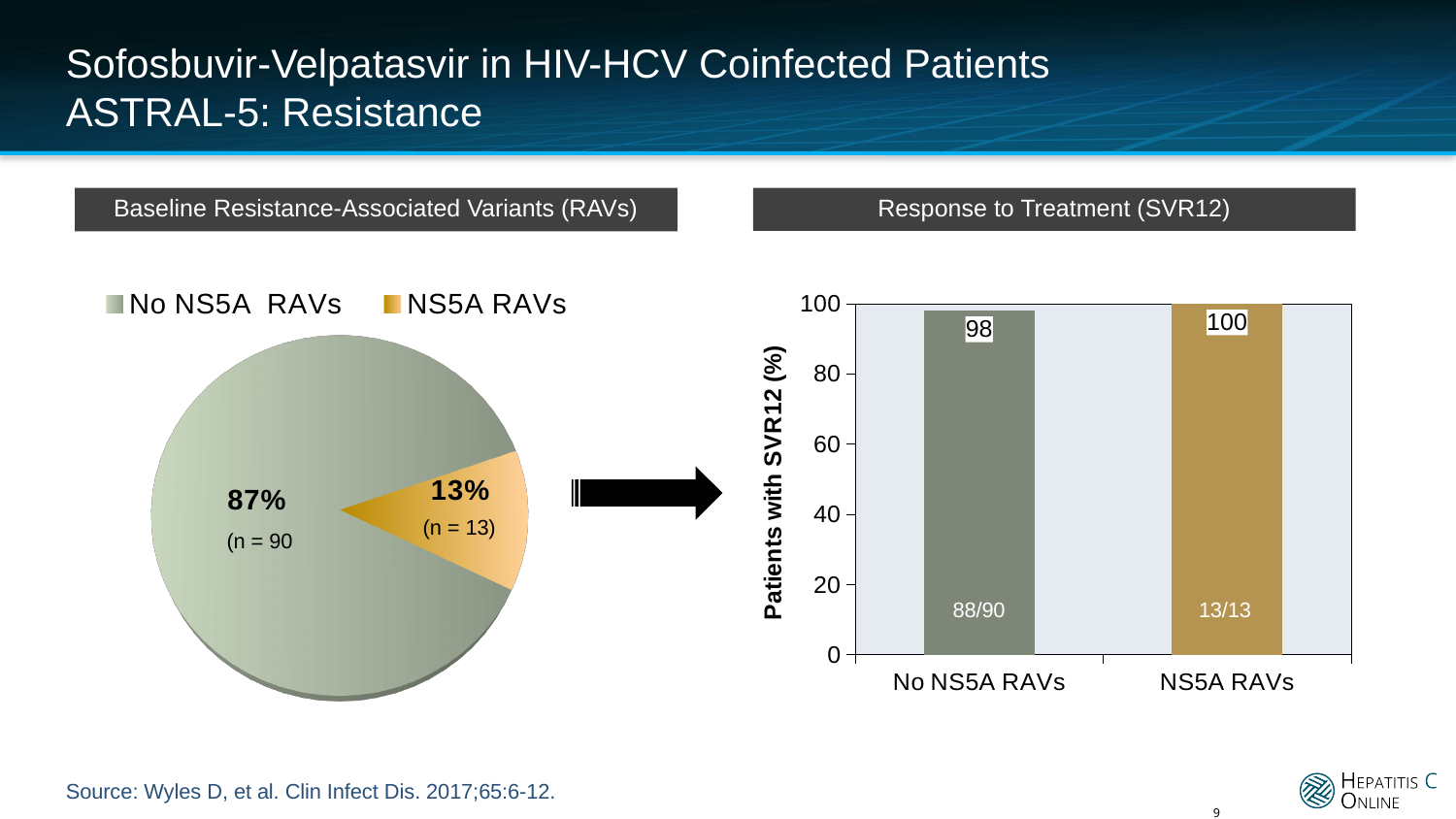
In the Baseline Resistance-Associated Variants (RAVs) pie chart, how many patients are in the No NS5A RAVs slice? n = 90 In the Response to Treatment (SVR12) chart, what is the difference in SVR12 percentage between the NS5A RAVs and No NS5A RAVs groups? 2 In the Baseline Resistance-Associated Variants (RAVs) pie chart, what share of patients had NS5A RAVs? 13% What kind of chart is the Baseline Resistance-Associated Variants (RAVs) chart on the left? Pie chart In the Response to Treatment (SVR12) chart, what percentage of patients with NS5A RAVs achieved SVR12? 100 In the Response to Treatment (SVR12) chart, which group has the higher SVR12 rate? NS5A RAVs In the Response to Treatment (SVR12) chart, what percentage of patients with No NS5A RAVs achieved SVR12? 98 In the Baseline Resistance-Associated Variants (RAVs) pie chart, what share of patients had No NS5A RAVs? 87% In the Baseline Resistance-Associated Variants (RAVs) pie chart, how many patients are in the NS5A RAVs slice? n = 13 How many entries does the legend of the Baseline Resistance-Associated Variants (RAVs) pie chart list? 2 In the Response to Treatment (SVR12) chart, what fraction is printed on the No NS5A RAVs bar? 88/90 What kind of chart is the Response to Treatment (SVR12) chart on the right? Bar chart